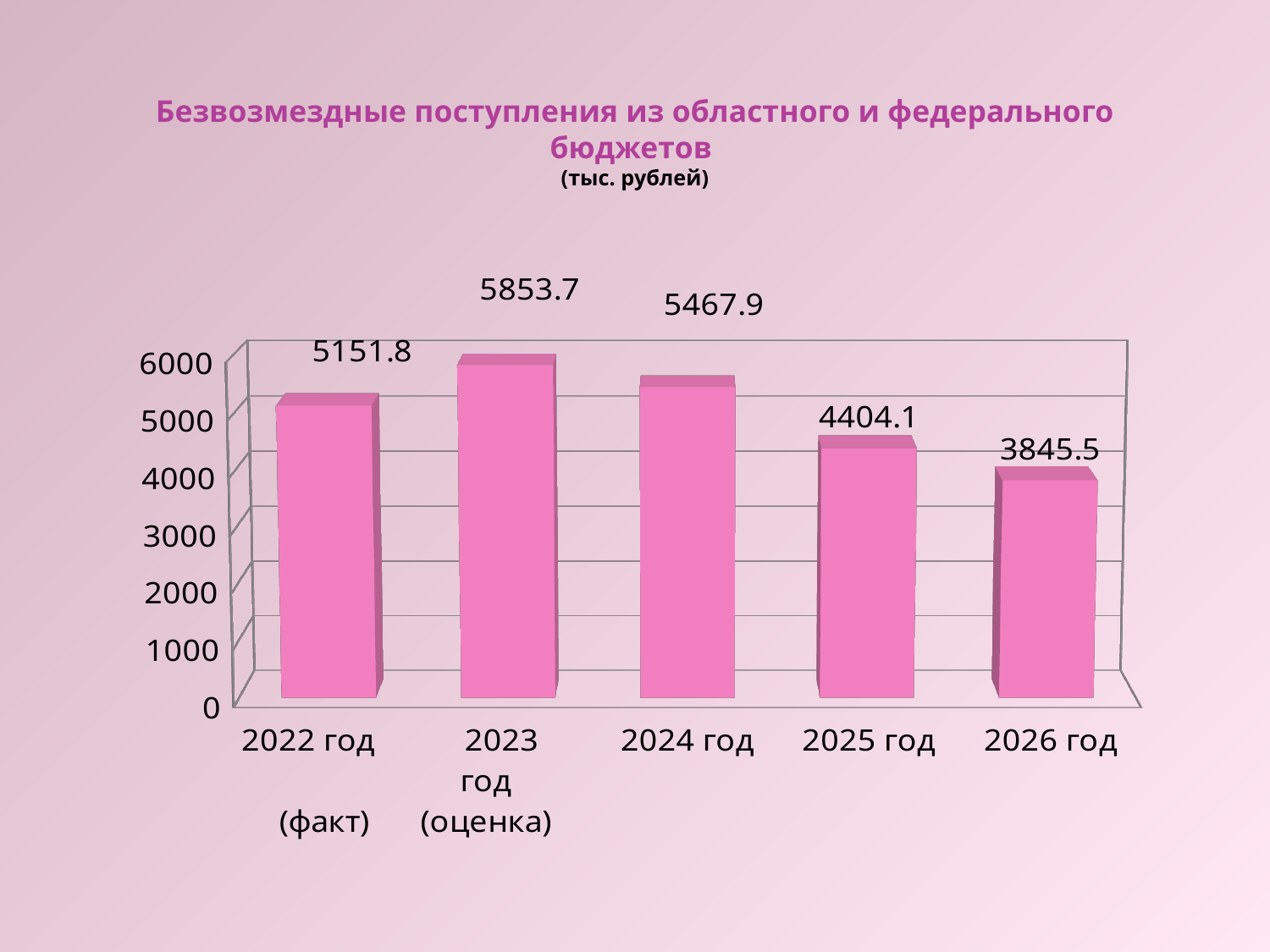
Which year has the lowest value? 2026 год Which is larger, the value for 2022 год (факт) or the value for 2024 год? 2024 год What is the value for 2026 год? 3845.5 Is the value for 2025 год greater or less than 5000? less What is the value for 2022 год (факт)? 5151.8 What kind of chart is shown on the slide? bar chart What is the difference between the values for 2025 год and 2026 год? 558.6 What is the value for 2023 год (оценка)? 5853.7 What is the difference between the values for 2023 год (оценка) and 2024 год? 385.8 From 2023 год (оценка) to 2026 год, do the values rise or fall? fall Which year has the highest value? 2023 год (оценка) How many years are shown on the chart? 5